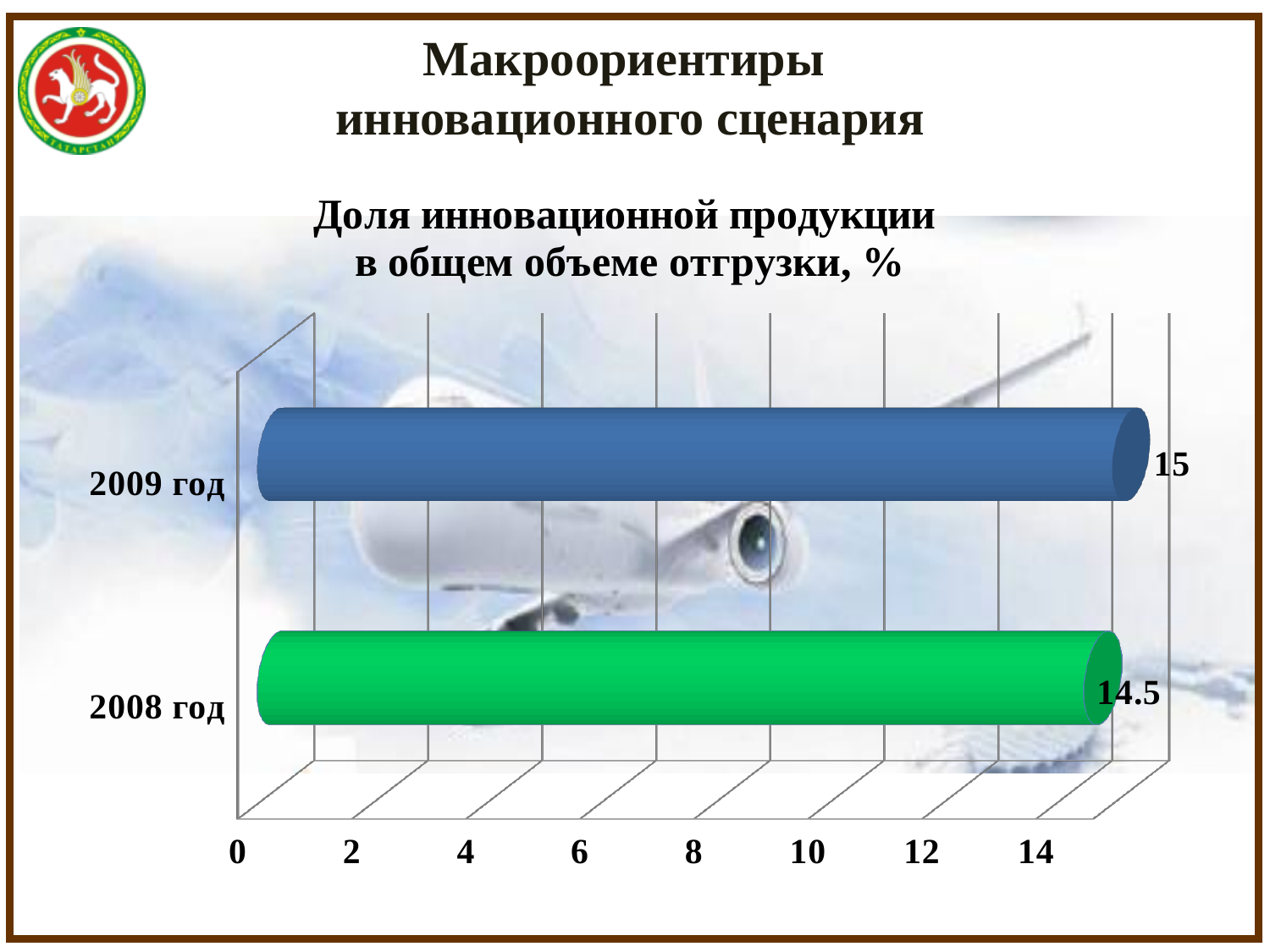
Is the value for 2009 год greater or less than 12? greater Which is larger, the value for 2009 год or for 2008 год? 2009 год What is the title of the chart? Доля инновационной продукции в общем объеме отгрузки, % What kind of chart is shown on the slide? bar chart What is the difference between the values for 2009 год and 2008 год? 0.5 Which year has the highest share of innovative products? 2009 год What is the value for 2009 год? 15 Is the value for 2008 год greater or less than 14? greater How many categories are shown in the chart? 2 What is the value for 2008 год? 14.5 What colour is the bar for 2008 год? green Which year has the lowest share of innovative products? 2008 год